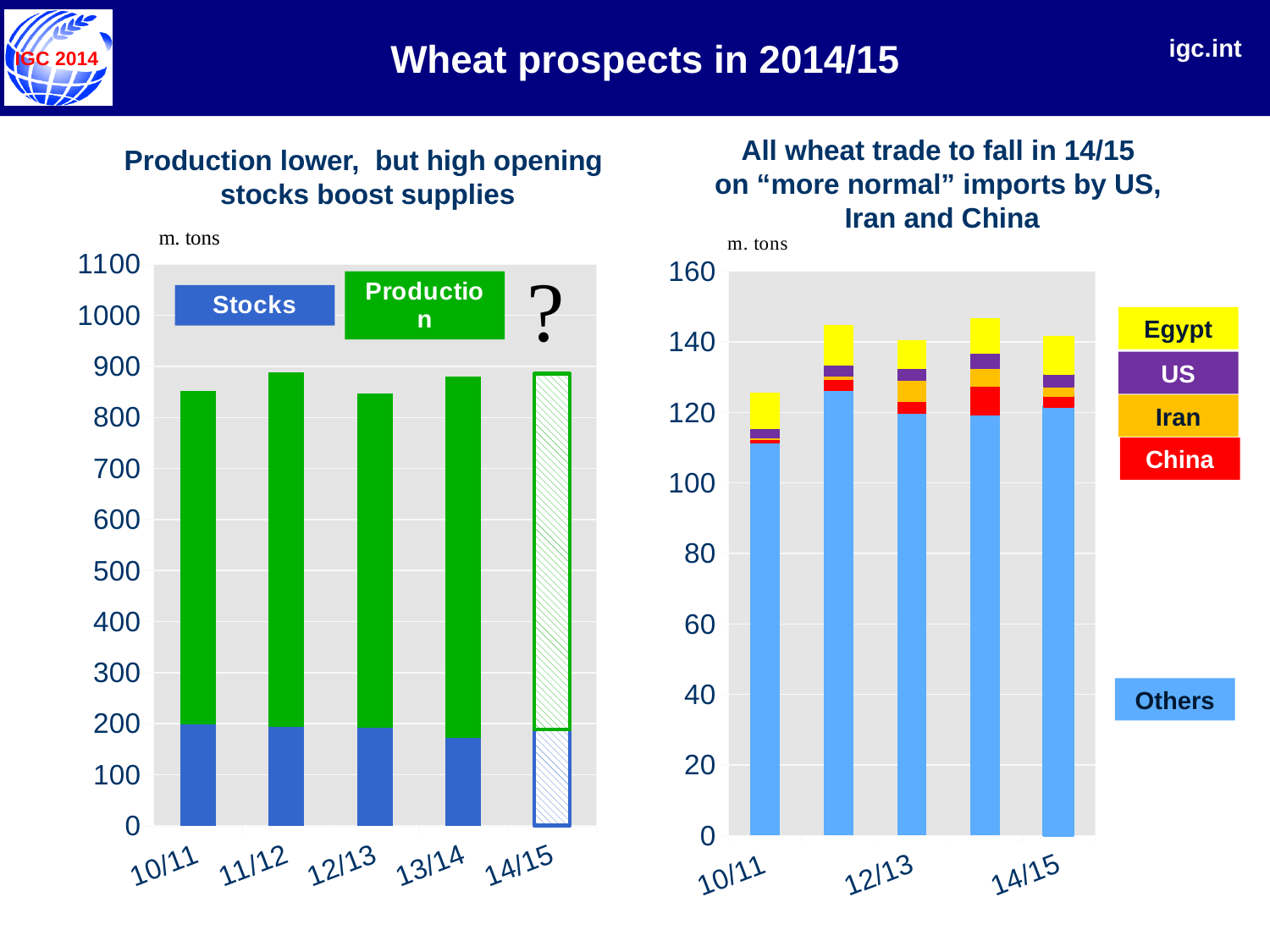
On the right chart, is the total bar for 12/13 greater or less than 160? less What type of chart is the left chart titled "Production lower, but high opening stocks boost supplies"? stacked bar chart On the right chart, which season has the lowest total wheat trade? 10/11 How many series does the legend of the left chart list? 2 On the left chart, is the total bar for 14/15 greater or less than 1000? less On the right chart, is the total bar for 10/11 greater or less than 120? greater What unit is shown on the y axis of the right chart? m. tons On the right chart, which is larger: the total for 10/11 or the total for 12/13? 12/13 How many bars (seasons) are shown on the left chart? 5 How many series does the legend of the right chart list? 5 On the left chart, which colour represents Stocks? blue